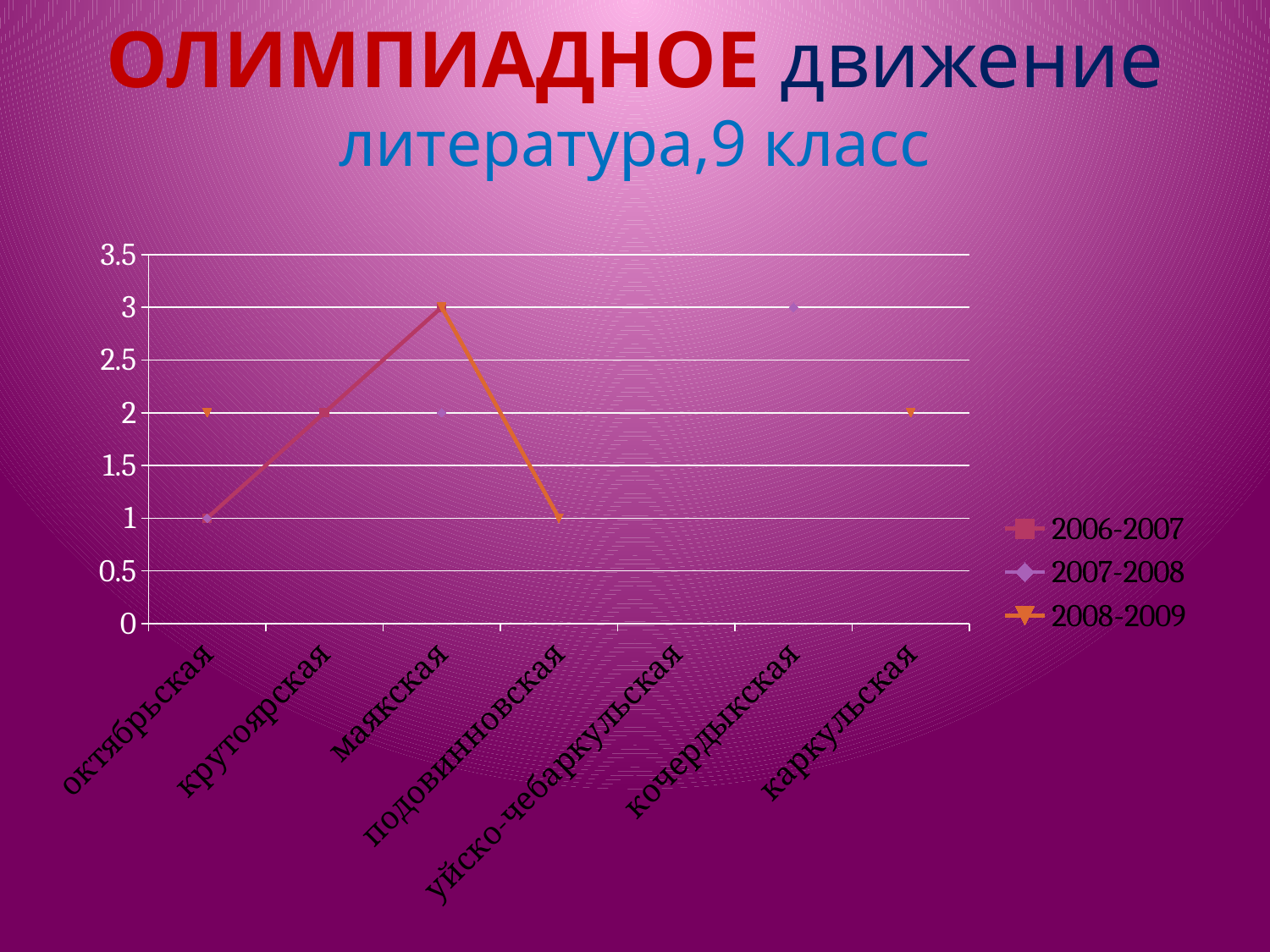
How many categories are shown on the x axis? 7 In the 2008-2009 series, what is the difference between the values for маякская and подовинновская? 2 How many series does the legend list? 3 Which series are listed in the legend? 2006-2007, 2007-2008, 2008-2009 In the 2008-2009 series, which category has the highest value? маякская What is the value for кочердыкская in the 2007-2008 series? 3 What is the value for подовинновская in the 2008-2009 series? 1 What is the value for каркульская in the 2008-2009 series? 2 In the 2008-2009 series, which category has the lowest value? подовинновская What type of chart is shown on the slide? line chart In the 2008-2009 series, which is larger: the value for октябрьская or the value for подовинновская? октябрьская What is the value for крутоярская in the 2006-2007 series? 2